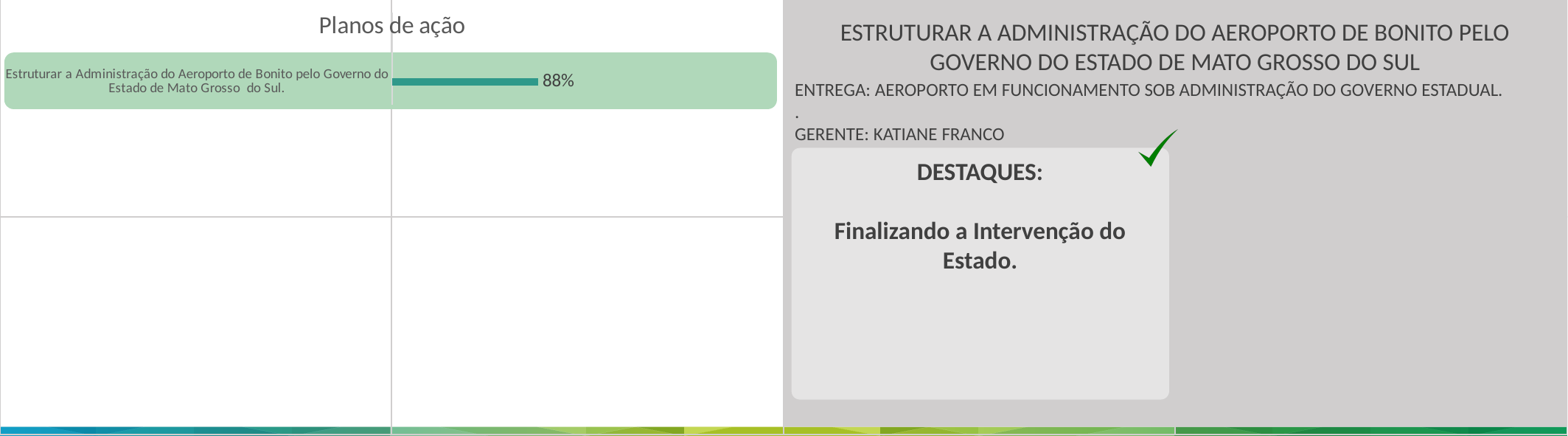
What kind of chart is the Planos de ação chart? bar chart What is the title of the chart on the left of the slide? Planos de ação What is the value shown for "Estruturar a Administração do Aeroporto de Bonito pelo Governo do Estado de Mato Grosso do Sul" in the Planos de ação chart? 88% Are the bars in the Planos de ação chart horizontal or vertical? horizontal What is the highest value shown in the Planos de ação chart? 88% How many categories are plotted in the Planos de ação chart? 1